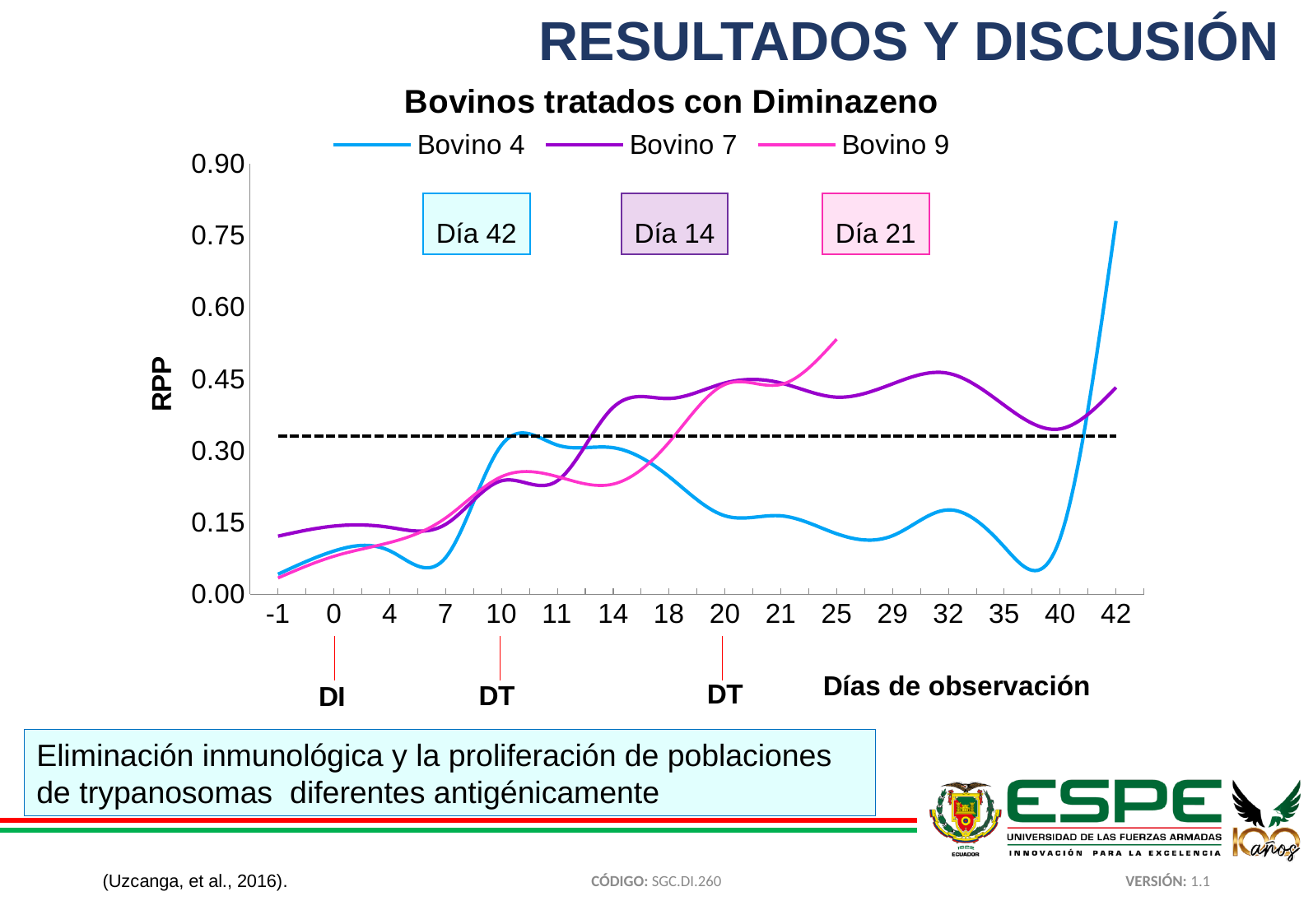
What kind of chart is shown on the slide? line chart What is the title of the chart? Bovinos tratados con Diminazeno Which series is drawn in pink in the legend? Bovino 9 Is the value for Bovino 7 at day -1 greater or less than 0.15? less Is the value for Bovino 9 at day 25 greater or less than 0.45? greater At day 42, which is higher, Bovino 4 or Bovino 7? Bovino 4 How many series does the legend list? 3 At day 20, which is higher, Bovino 7 or Bovino 4? Bovino 7 Is the value for Bovino 4 at day 40 greater or less than 0.15? less How many observation days are marked on the x axis? 16 Which series reaches the highest RPP value on the chart? Bovino 4